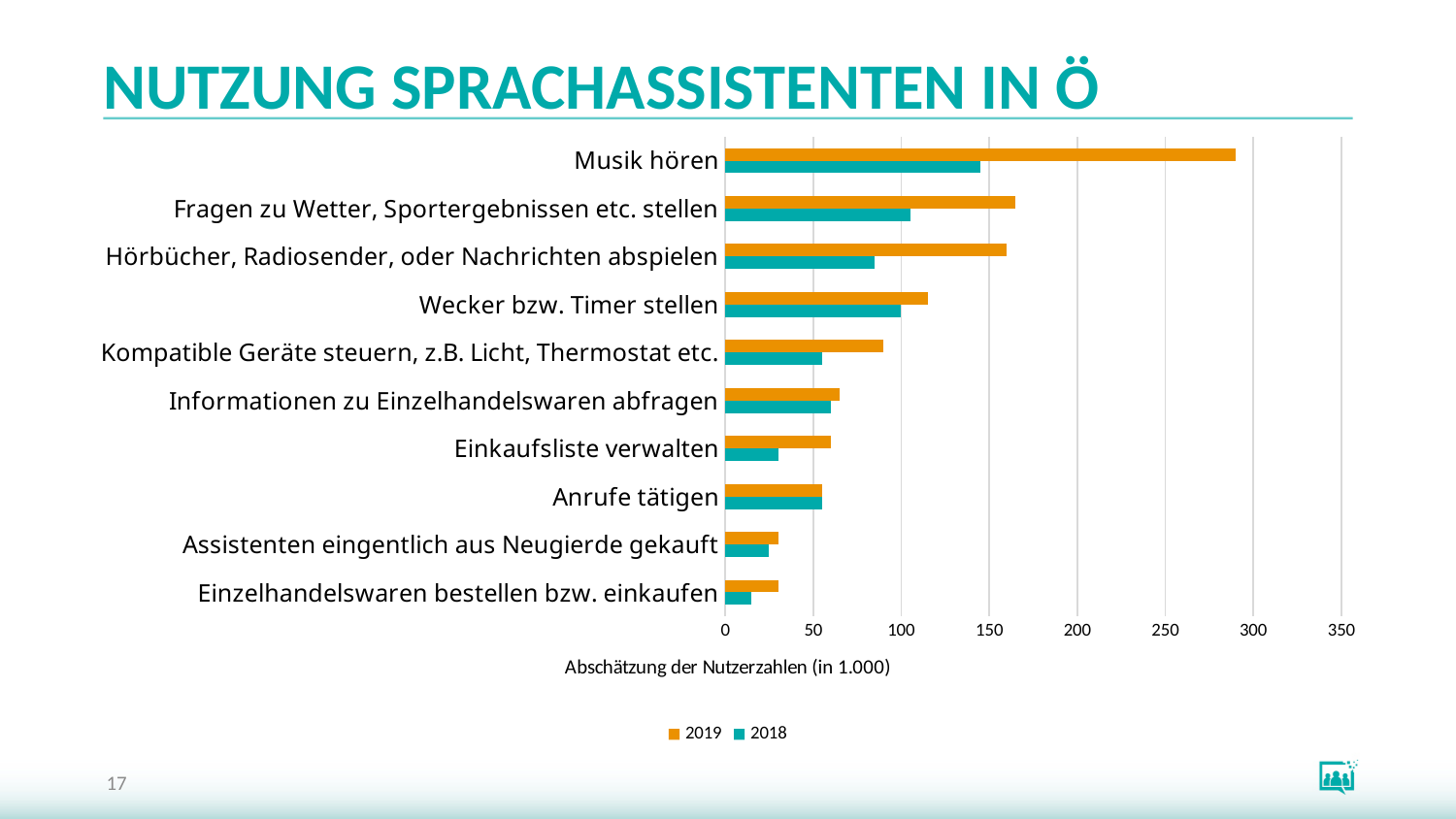
Is the 2018 value for Musik hören greater or less than 100? greater What is the label shown below the x axis? Abschätzung der Nutzerzahlen (in 1.000) Which category has the highest value for 2018? Musik hören Is the 2018 value for Einkaufsliste verwalten greater or less than 50? less For Fragen zu Wetter, Sportergebnissen etc. stellen, which year has the larger value, 2019 or 2018? 2019 Which category has the lowest value for 2018? Einzelhandelswaren bestellen bzw. einkaufen Is the 2019 value for Wecker bzw. Timer stellen greater or less than 100? greater Which category has the highest value for 2019? Musik hören What kind of chart is shown on the slide? bar chart How many series does the legend list? 2 How many categories are shown on the chart? 10